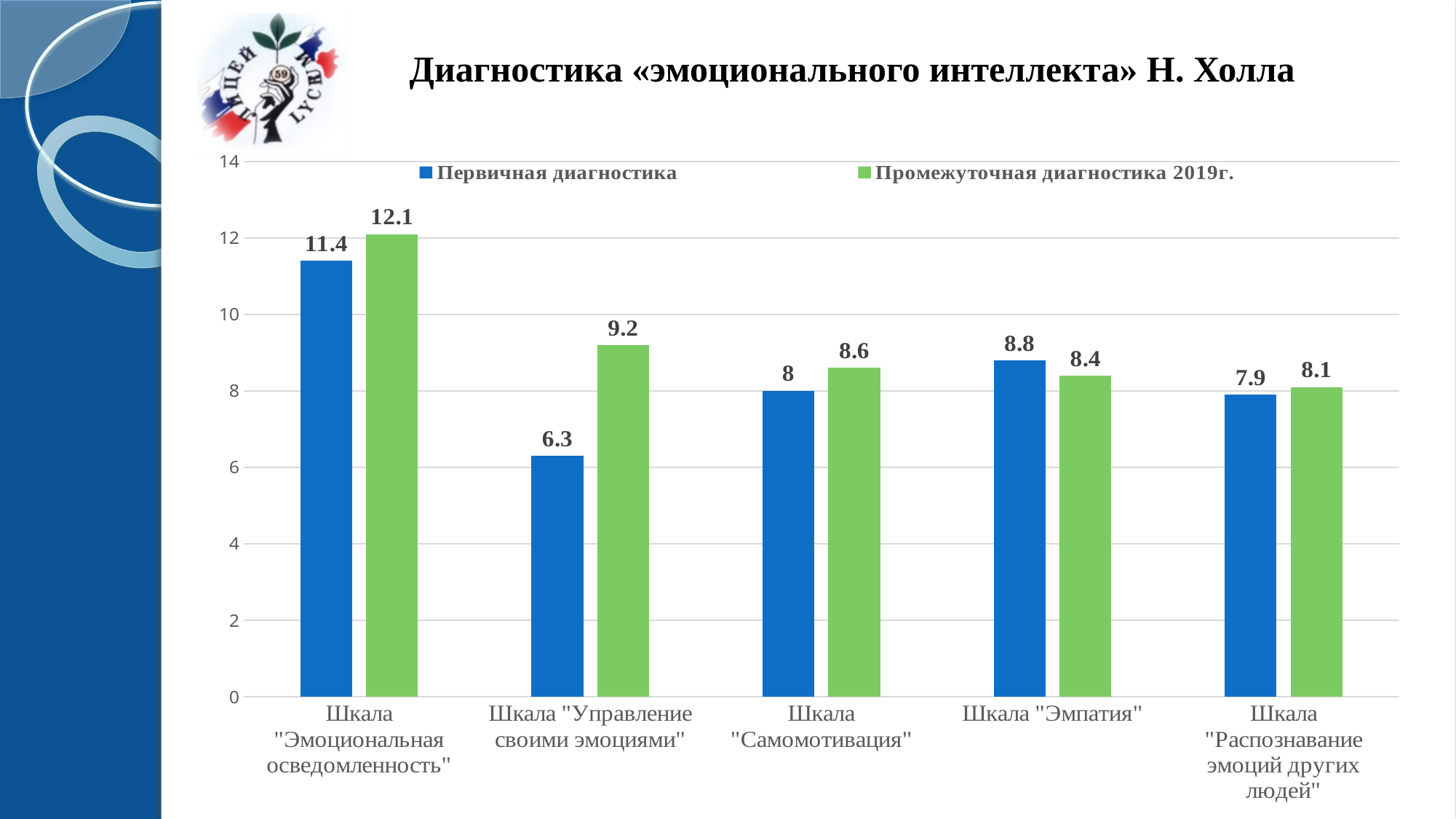
Which category has the highest value for "Промежуточная диагностика 2019г."? Шкала "Эмоциональная осведомленность" What is the difference between the "Промежуточная диагностика 2019г." and "Первичная диагностика" values for Шкала "Управление своими эмоциями"? 2.9 How many series does the legend list? 2 For Шкала "Эмпатия", which series has the larger value: "Первичная диагностика" or "Промежуточная диагностика 2019г."? Первичная диагностика What colour are the bars for "Промежуточная диагностика 2019г."? Green How many categories are shown on the x axis? 5 What kind of chart is shown on the slide? Bar chart What is the value of "Промежуточная диагностика 2019г." for Шкала "Управление своими эмоциями"? 9.2 What is the value of "Промежуточная диагностика 2019г." for Шкала "Распознавание эмоций других людей"? 8.1 What is the value of "Первичная диагностика" for Шкала "Самомотивация"? 8 What is the value of "Первичная диагностика" for Шкала "Эмоциональная осведомленность"? 11.4 Which category has the lowest value for "Первичная диагностика"? Шкала "Управление своими эмоциями"